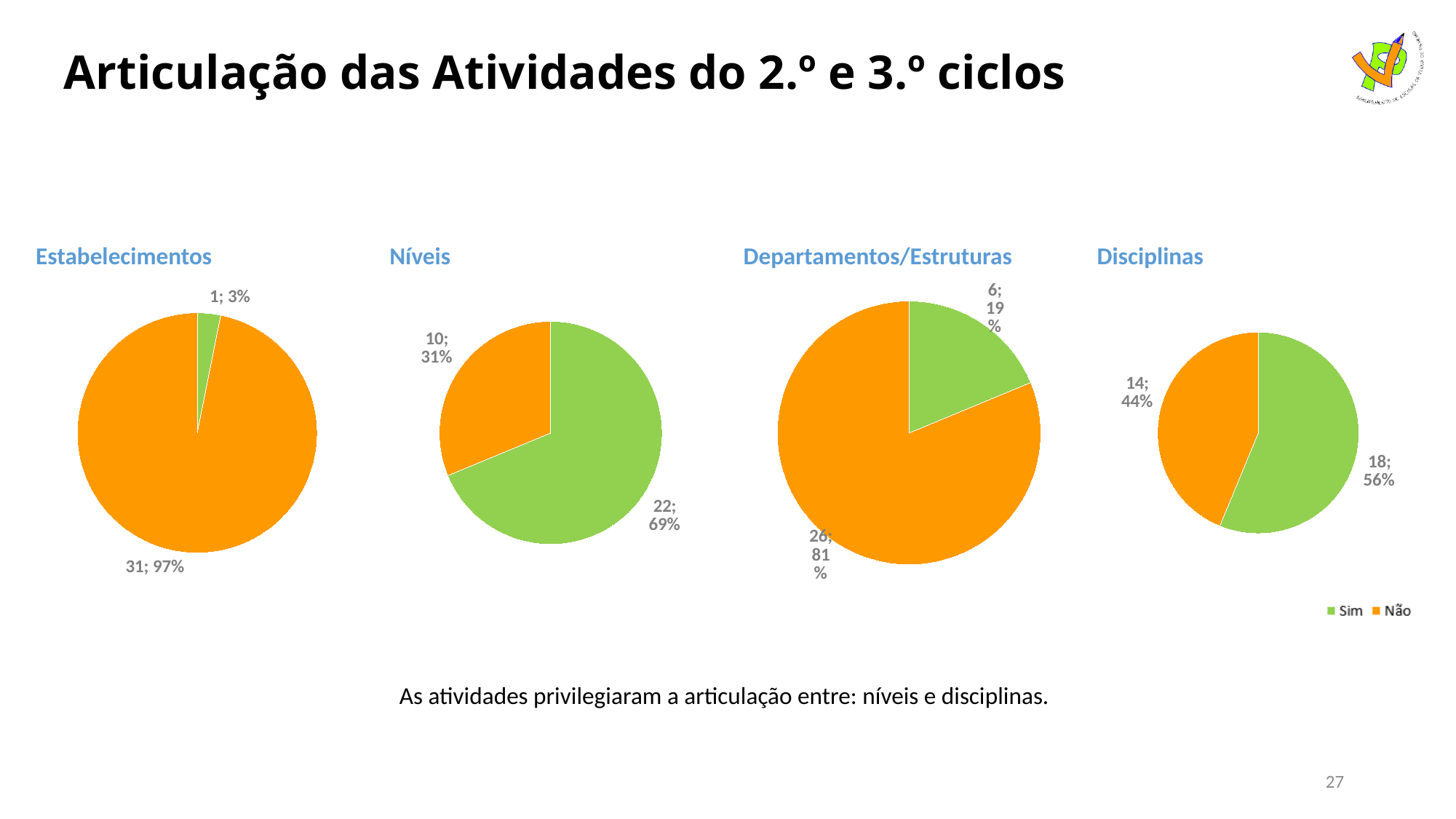
In the Estabelecimentos pie chart, what is the value for Não? 31; 97% In the Disciplinas pie chart, what is the value for Sim? 18; 56% How many series does the legend list? 2 In the Estabelecimentos pie chart, what share of the pie does Sim take? 3% In the Níveis pie chart, what is the value for Sim? 22; 69% In the Níveis pie chart, what share of the pie does Não take? 31% What kind of chart is used for Estabelecimentos? Pie chart In the Departamentos/Estruturas pie chart, what is the value for Não? 26; 81% In the Departamentos/Estruturas pie chart, what is the total count of Sim and Não combined? 32 In the Níveis pie chart, what is the difference between the counts for Sim and Não? 12 In the Departamentos/Estruturas pie chart, what is the count for Sim? 6 In the Disciplinas pie chart, which slice is larger, Sim or Não? Sim